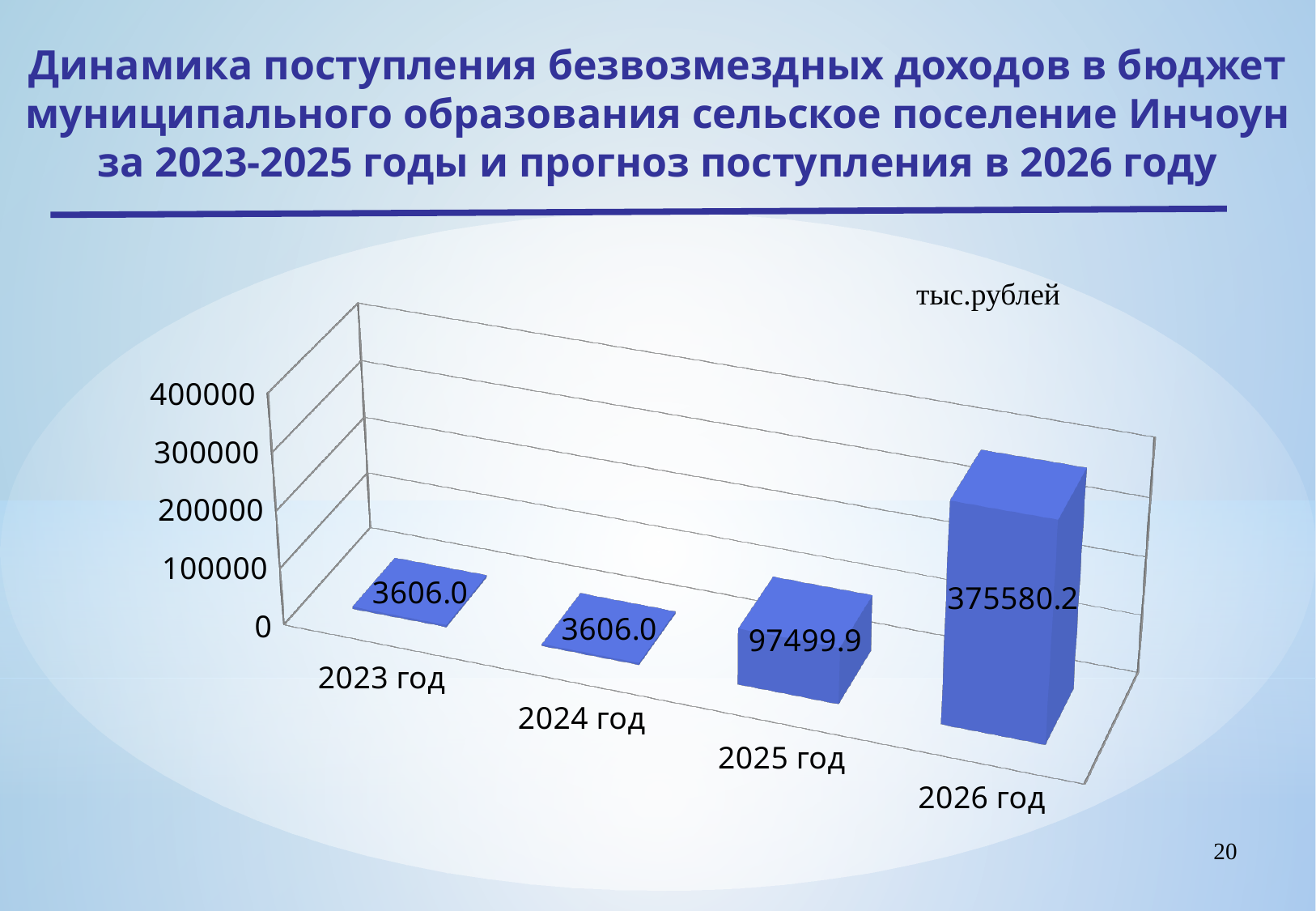
What is the difference between the values for 2026 год and 2025 год? 278080.3 What is the value for 2023 год? 3606.0 Which year has the highest value? 2026 год Which is larger, the value for 2025 год or the value for 2024 год? 2025 год What is the value for 2024 год? 3606.0 Is the value for 2026 год greater or less than 300000? greater What is the value for 2025 год? 97499.9 What kind of chart is shown on the slide? bar chart How many years are shown on the chart? 4 What is the difference between the values for 2025 год and 2024 год? 93893.9 What unit of measurement is indicated on the chart? тыс.рублей What is the forecast value for 2026 год? 375580.2